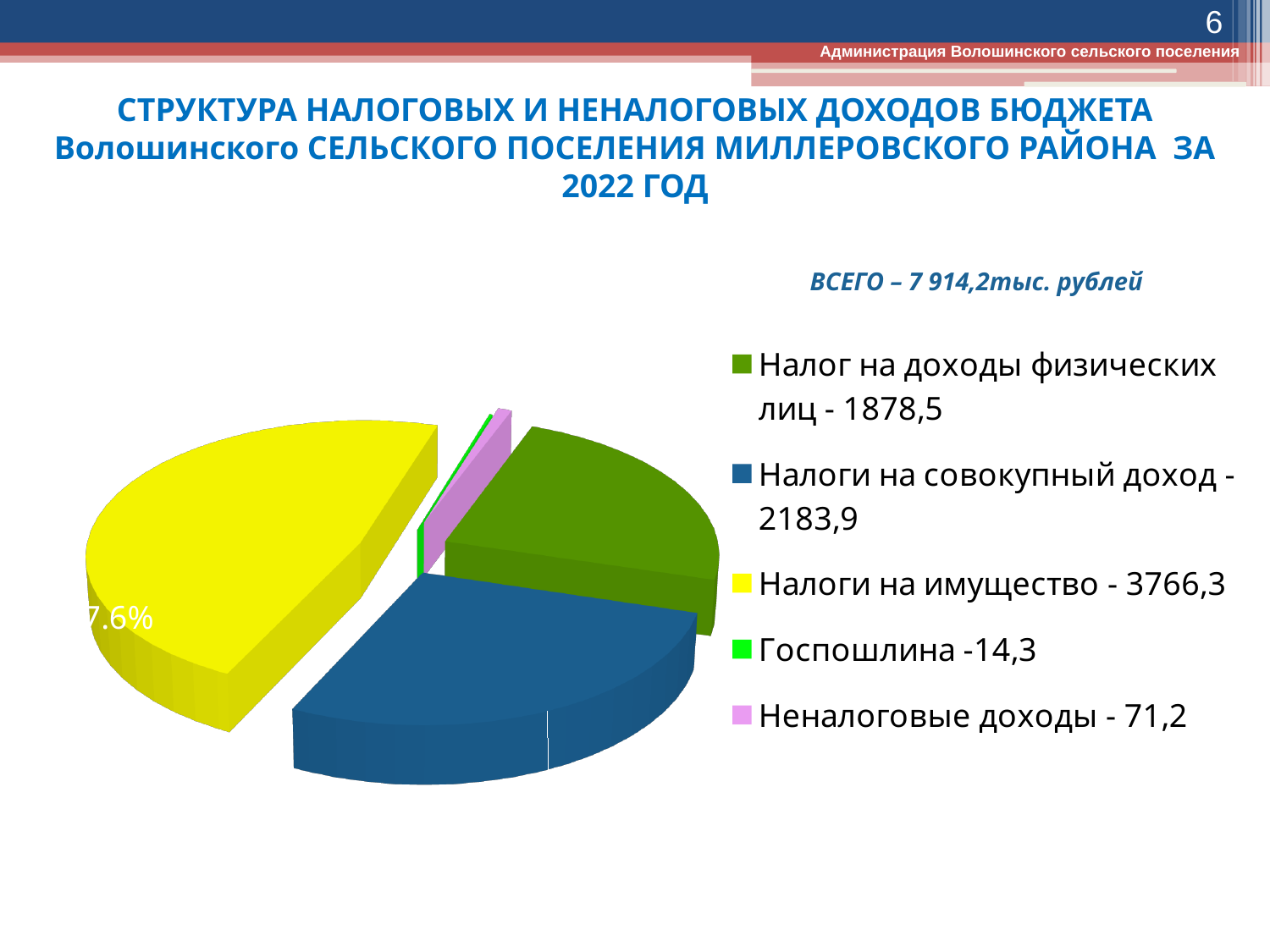
What is the value for Госпошлина? 14,3 What colour represents Налоги на имущество in the pie chart? Yellow What kind of chart is shown on the slide? Pie chart What is the difference between Налоги на имущество and Налоги на совокупный доход? 1582,4 Which category has the largest value? Налоги на имущество What is the value for Налог на доходы физических лиц? 1878,5 What is the value for Налоги на имущество? 3766,3 Which category has the smallest value? Госпошлина What is the value for Неналоговые доходы? 71,2 What total amount is stated above the legend (ВСЕГО)? 7 914,2тыс. рублей Which is larger: Налоги на совокупный доход or Налог на доходы физических лиц? Налоги на совокупный доход How many categories does the pie chart have? 5